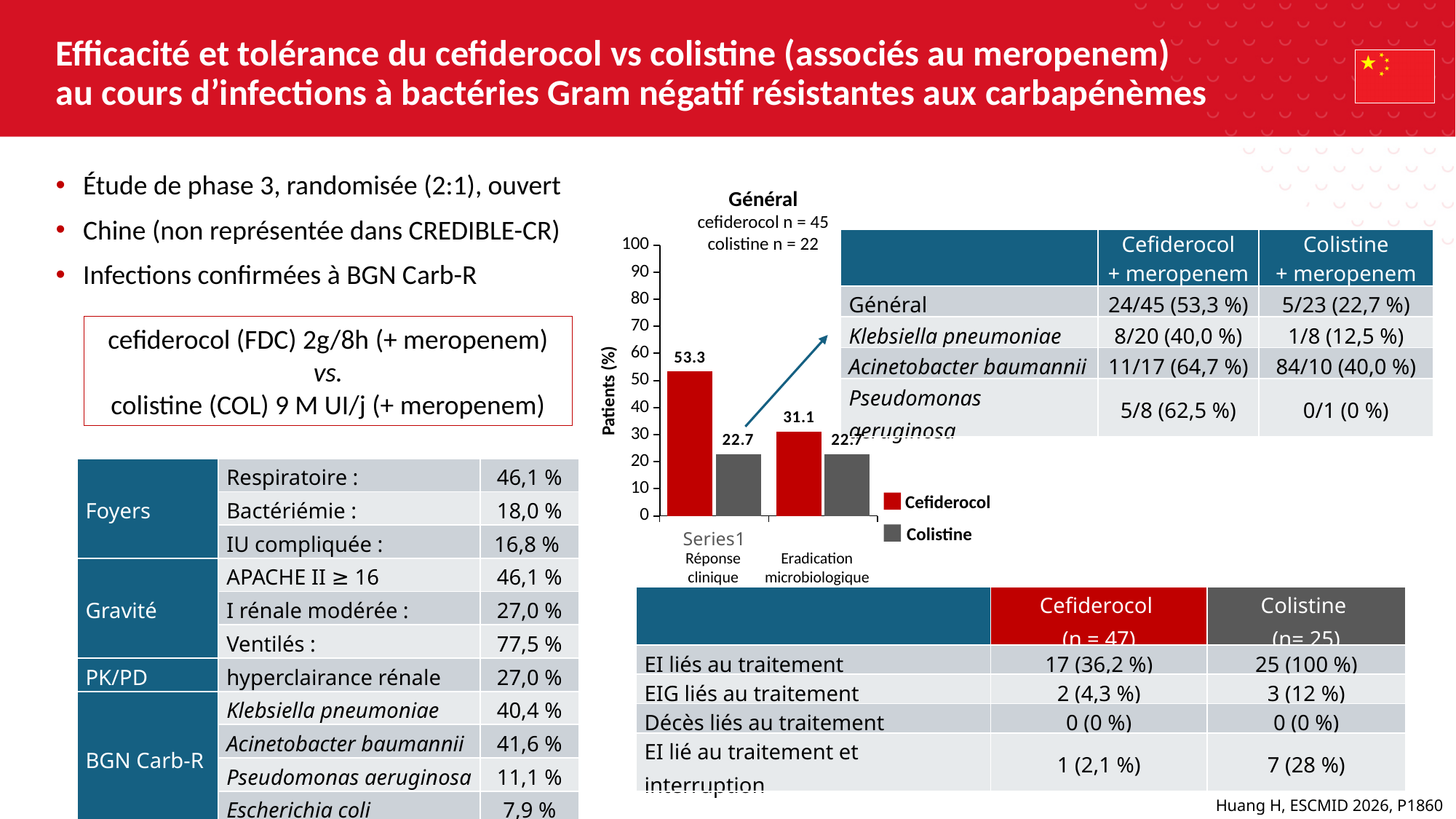
What is the difference between Cefiderocol and Colistine for Réponse clinique? 30.6 What type of chart is shown on the slide? bar chart What is the value for Colistine for Eradication microbiologique? 22.7 What is the label of the y axis of the chart? Patients (%) What is the value for Cefiderocol for Réponse clinique? 53.3 What is the value for Colistine for Réponse clinique? 22.7 What is the difference between Cefiderocol and Colistine for Eradication microbiologique? 8.4 How many series does the chart legend list? 2 Which bar in the chart has the highest value? Cefiderocol, Réponse clinique Is the value for Cefiderocol for Réponse clinique greater or less than 50? greater What is the value for Cefiderocol for Eradication microbiologique? 31.1 Which series has the higher value for Eradication microbiologique, Cefiderocol or Colistine? Cefiderocol